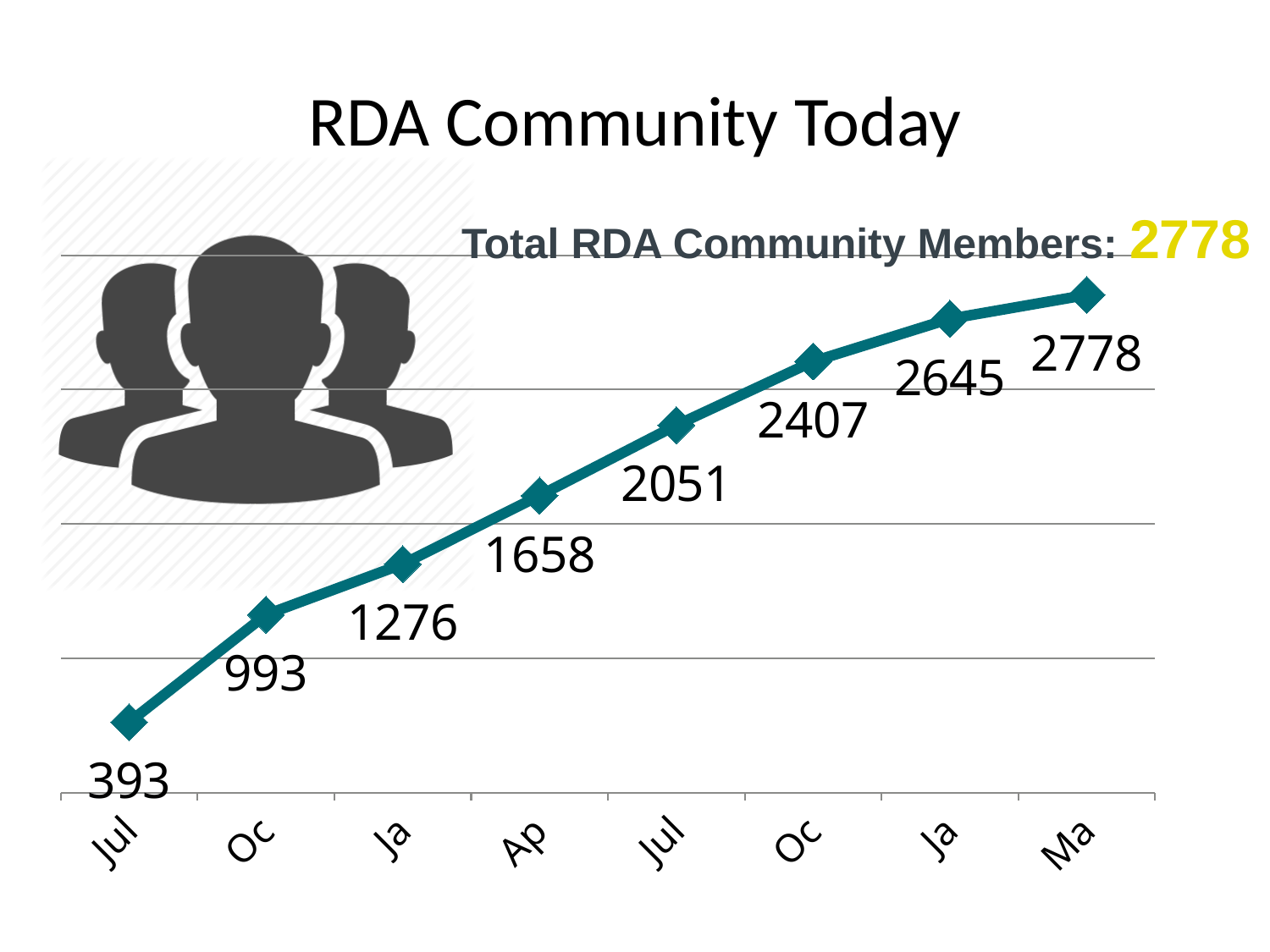
What is the value of the first data point, labelled Jul? 393 Which data point has the lowest value? Jul (the first point) Do the values rise or fall from left to right along the x axis? rise What type of chart is shown on the slide? line chart Which data point has the highest value? Ma How many data points are plotted on the line chart? 8 What total number of RDA Community Members is stated in the text above the chart? 2778 What is the value of the second data point labelled Oc (the sixth point on the chart)? 2407 What is the difference between the last value (Ma, 2778) and the first value (Jul, 393)? 2385 What is the difference between the values at Ap (1658) and the first Ja (1276)? 382 What is the value of the data point labelled Ap? 1658 What is the value of the last data point, labelled Ma? 2778